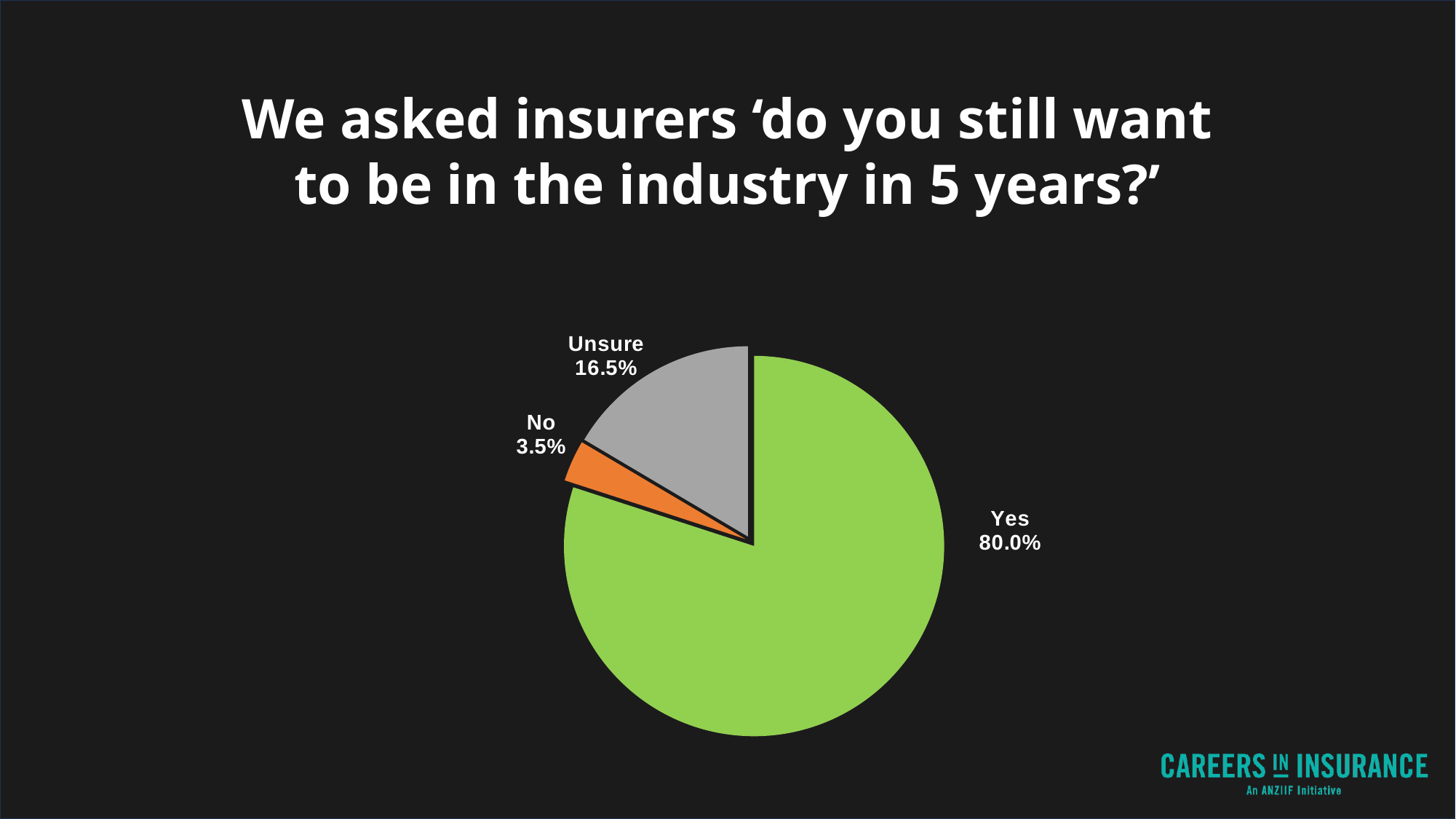
What percentage of insurers answered 'Yes'? 80.0% What percentage of insurers answered 'No'? 3.5% Which response has the smallest share of the pie? No What is the difference in percentage points between the 'Unsure' and 'No' slices? 13.0 What is the difference in percentage points between the 'Yes' and 'Unsure' slices? 63.5 What percentage of insurers answered 'Unsure'? 16.5% What colour is the 'Yes' slice of the pie? Green Which slice is larger, 'Unsure' or 'No'? Unsure What colour is the 'No' slice of the pie? Orange What kind of chart is shown on the slide? Pie chart Which response has the largest share of the pie? Yes How many response categories are shown in the pie chart? 3